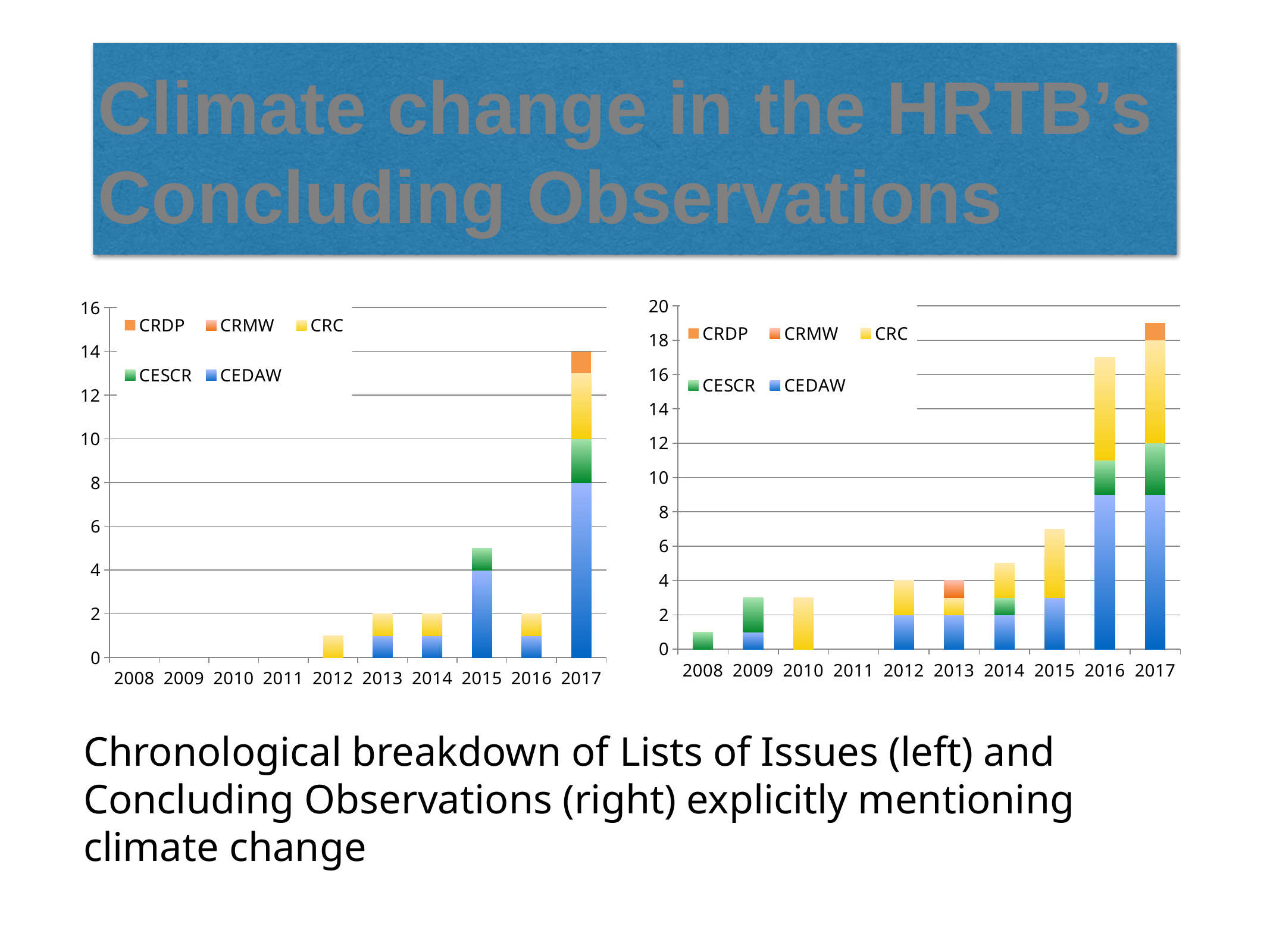
In the left chart (Lists of Issues), what is the total height of the stacked bar for 2017? 14 In the right chart (Concluding Observations), which year has the larger total, 2015 or 2016? 2016 How many years are shown on the x axis of the left chart? 10 In the right chart (Concluding Observations), which year has the tallest bar? 2017 In the left chart (Lists of Issues), what is the total height of the stacked bar for 2013? 2 In the right chart (Concluding Observations), which year between 2008 and 2017 has no bar at all? 2011 How many series does the legend of the right chart list? 5 In the right chart (Concluding Observations), is the total for 2016 greater or less than 14? greater In the right chart (Concluding Observations), what is the total height of the stacked bar for 2012? 4 Which series is shown in blue in the legends of both charts? CEDAW What kind of chart is the left chart on the slide? Stacked bar chart In the left chart (Lists of Issues), which year has the tallest bar? 2017